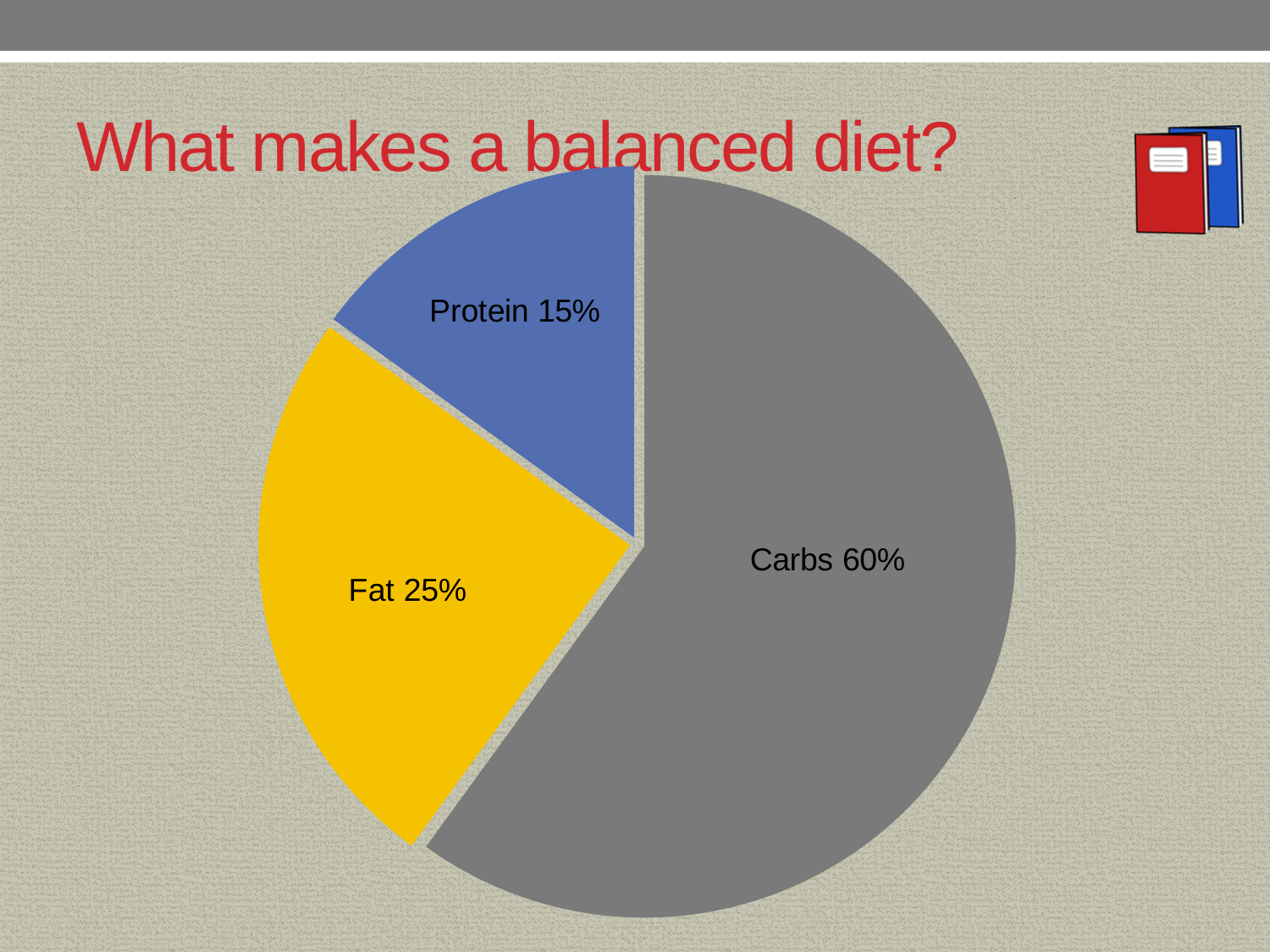
What colour is the Carbs slice? grey How many slices does the pie chart have? 3 What kind of chart is shown on the slide? pie chart What share of the pie does Fat take? 25% Which is larger, the Fat slice or the Protein slice? Fat What share of the pie does Protein take? 15% Which slice of the pie is the smallest? Protein What share of the pie does Carbs take? 60% What is the difference in percentage points between Fat and Protein? 10 What is the title of the slide containing the pie chart? What makes a balanced diet? What is the difference in percentage points between Carbs and Fat? 35 Which slice of the pie is the largest? Carbs